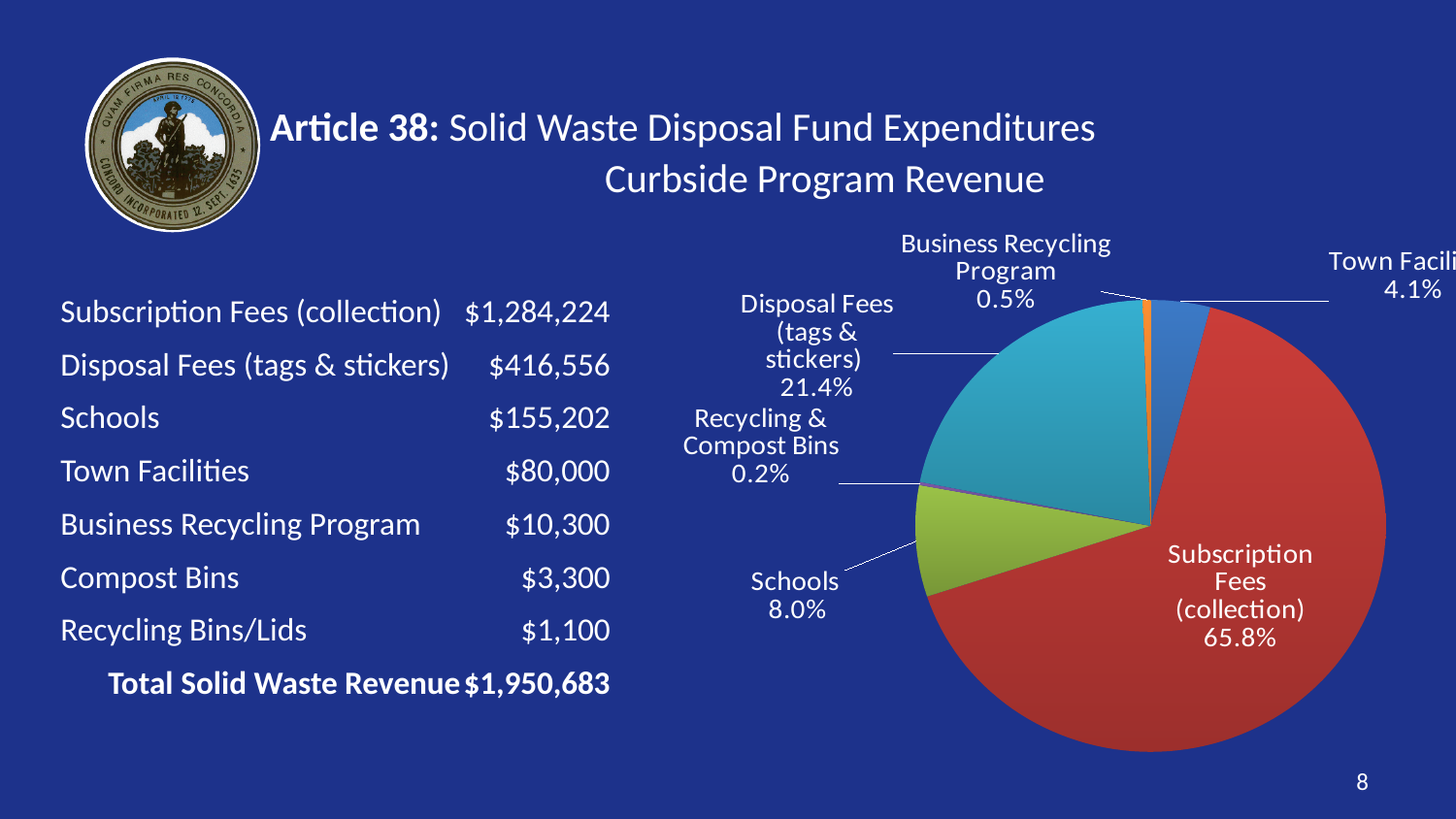
What percentage is shown for Recycling & Compost Bins in the pie chart? 0.2% Which slice is larger in the pie chart, Schools or Town Facilities? Schools How many slices are labeled in the pie chart? 6 What share of the pie does Subscription Fees (collection) represent? 65.8% What percentage is shown for Schools in the pie chart? 8.0% What percentage is shown for Disposal Fees (tags & stickers) in the pie chart? 21.4% What kind of chart is shown on the slide? pie chart What is the difference in percentage points between the Disposal Fees (tags & stickers) slice and the Schools slice? 13.4 What percentage is shown for Town Facilities in the pie chart? 4.1% What percentage is shown for Business Recycling Program in the pie chart? 0.5% Which category has the smallest slice of the pie chart? Recycling & Compost Bins Which category has the largest slice of the pie chart? Subscription Fees (collection)